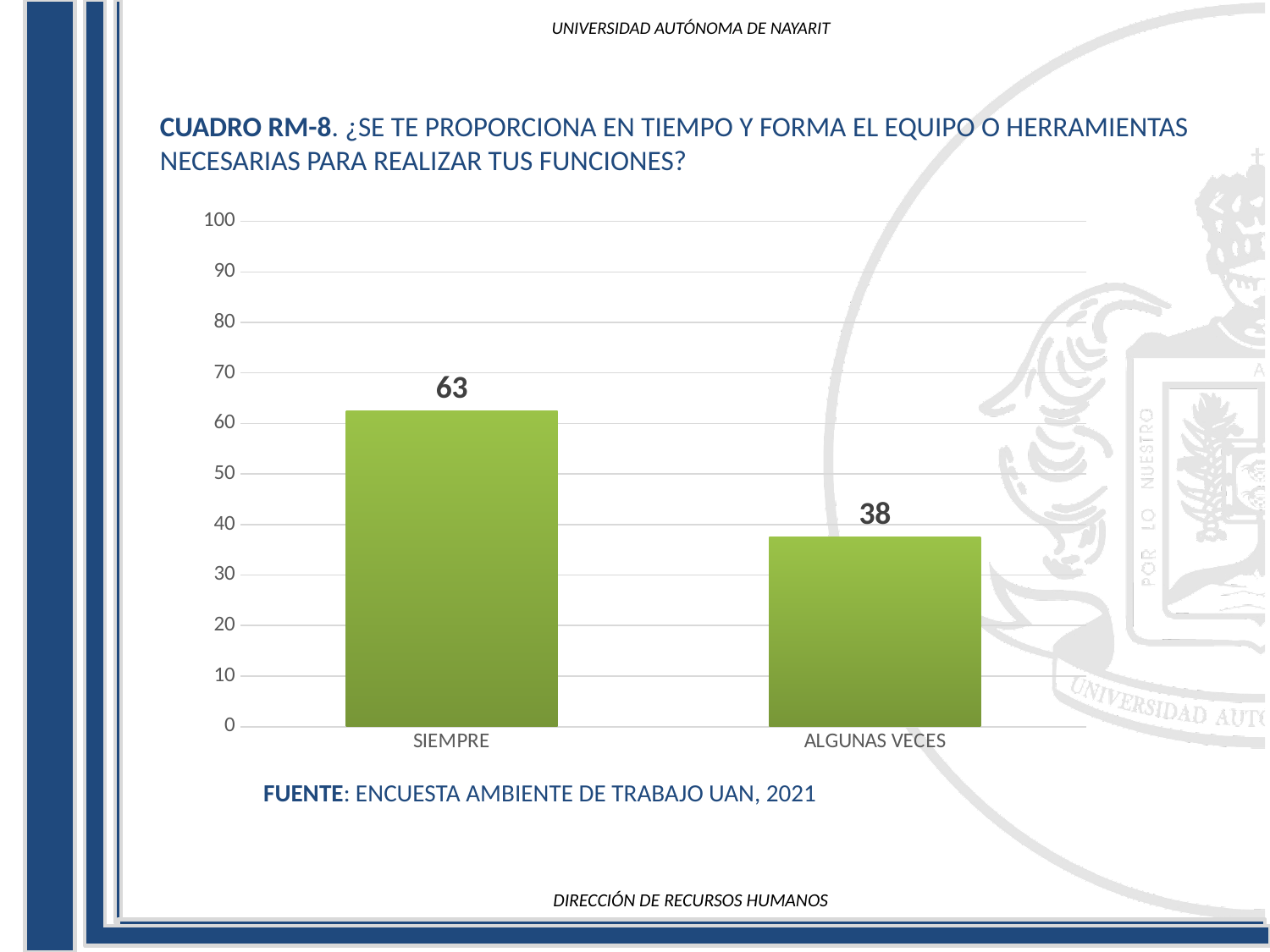
Which is larger, the value for SIEMPRE or the value for ALGUNAS VECES? SIEMPRE Is the value for ALGUNAS VECES greater or less than 50? less What source is cited below the chart? ENCUESTA AMBIENTE DE TRABAJO UAN, 2021 What is the value for SIEMPRE? 63 What is the difference between the values for SIEMPRE and ALGUNAS VECES? 25 How many categories are shown on the x axis? 2 What kind of chart is shown on the slide? bar chart Is the value for SIEMPRE greater or less than 60? greater Which category has the highest value? SIEMPRE What is the highest value shown on the y axis? 100 What is the value for ALGUNAS VECES? 38 Which category has the lowest value? ALGUNAS VECES